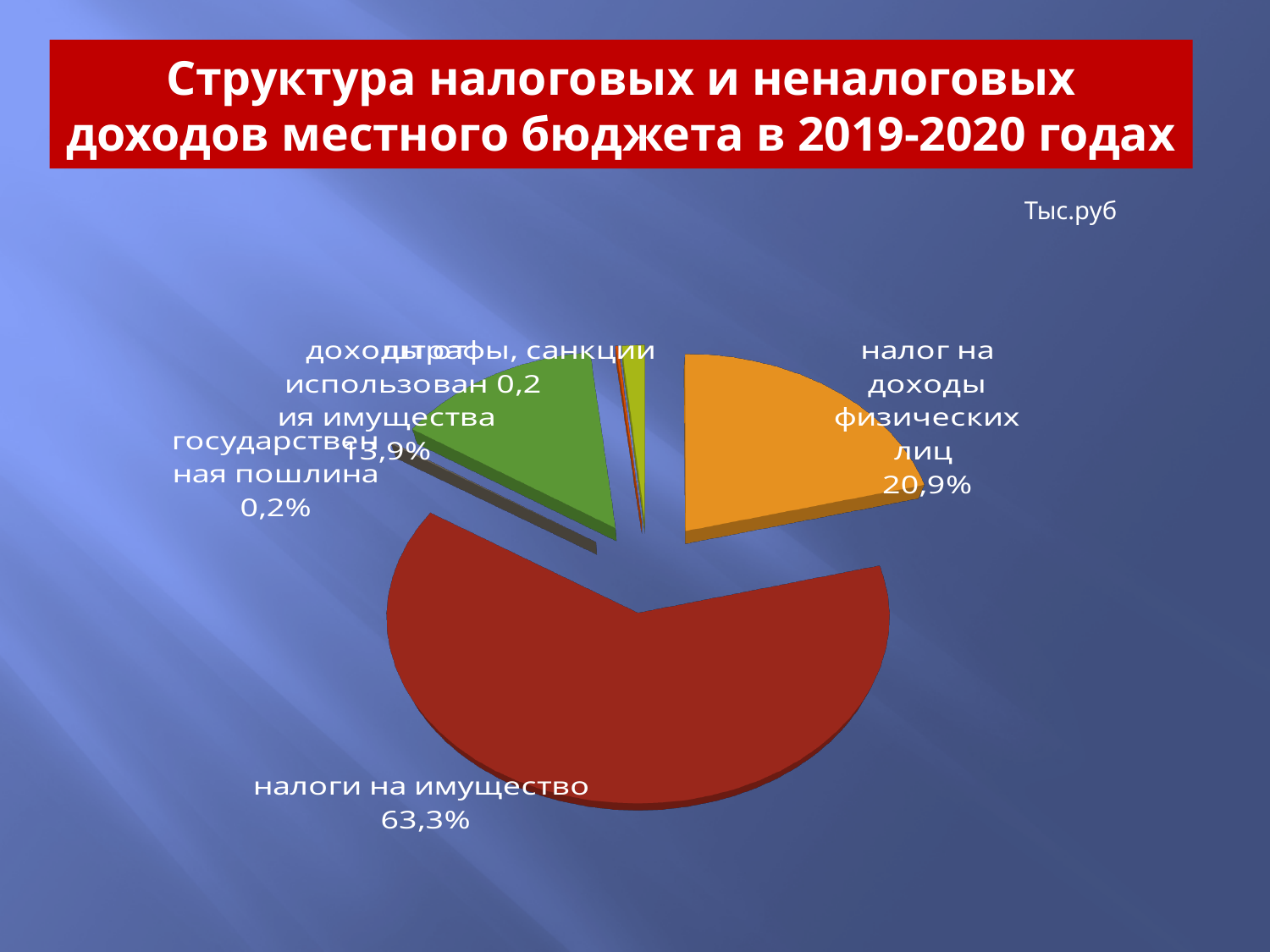
Is the share for налоги на имущество greater or less than 50%? greater What kind of chart is shown on the slide? pie chart What share of the pie is labelled for налоги на имущество? 63,3% What colour is the slice for налоги на имущество? red By how many percentage points does the share of налоги на имущество exceed that of налог на доходы физических лиц? 42,4% What share is shown for доходы от использования имущества? 13,9% Which category has the largest slice of the pie? налоги на имущество What share is shown for налог на доходы физических лиц? 20,9% By how many percentage points does the share of налог на доходы физических лиц exceed that of доходы от использования имущества? 7,0% What is the title of the slide? Структура налоговых и неналоговых доходов местного бюджета в 2019-2020 годах What share is shown for государственная пошлина? 0,2% Which is larger: the share for налог на доходы физических лиц or for доходы от использования имущества? налог на доходы физических лиц